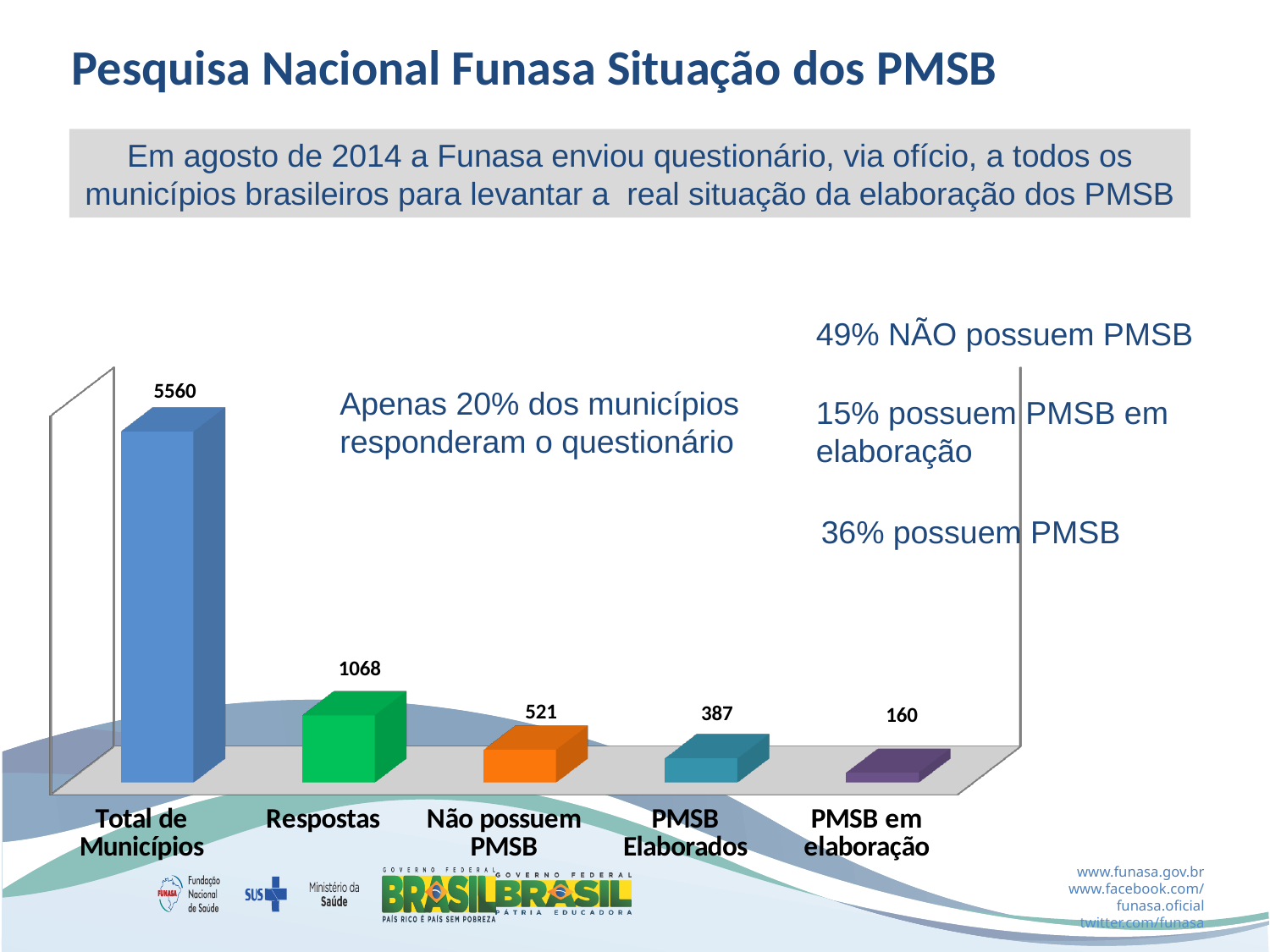
What is the value for PMSB Elaborados? 387 Which category has the lowest value? PMSB em elaboração What is the difference between Não possuem PMSB and PMSB Elaborados? 134 How many categories are shown in the chart? 5 What kind of chart is shown on the slide? Bar chart What is the value for Não possuem PMSB? 521 What is the value for Total de Municípios? 5560 Which is larger, PMSB Elaborados or PMSB em elaboração? PMSB Elaborados Which category has the highest value? Total de Municípios What is the value for PMSB em elaboração? 160 What is the difference between Total de Municípios and Respostas? 4492 What is the value for Respostas? 1068